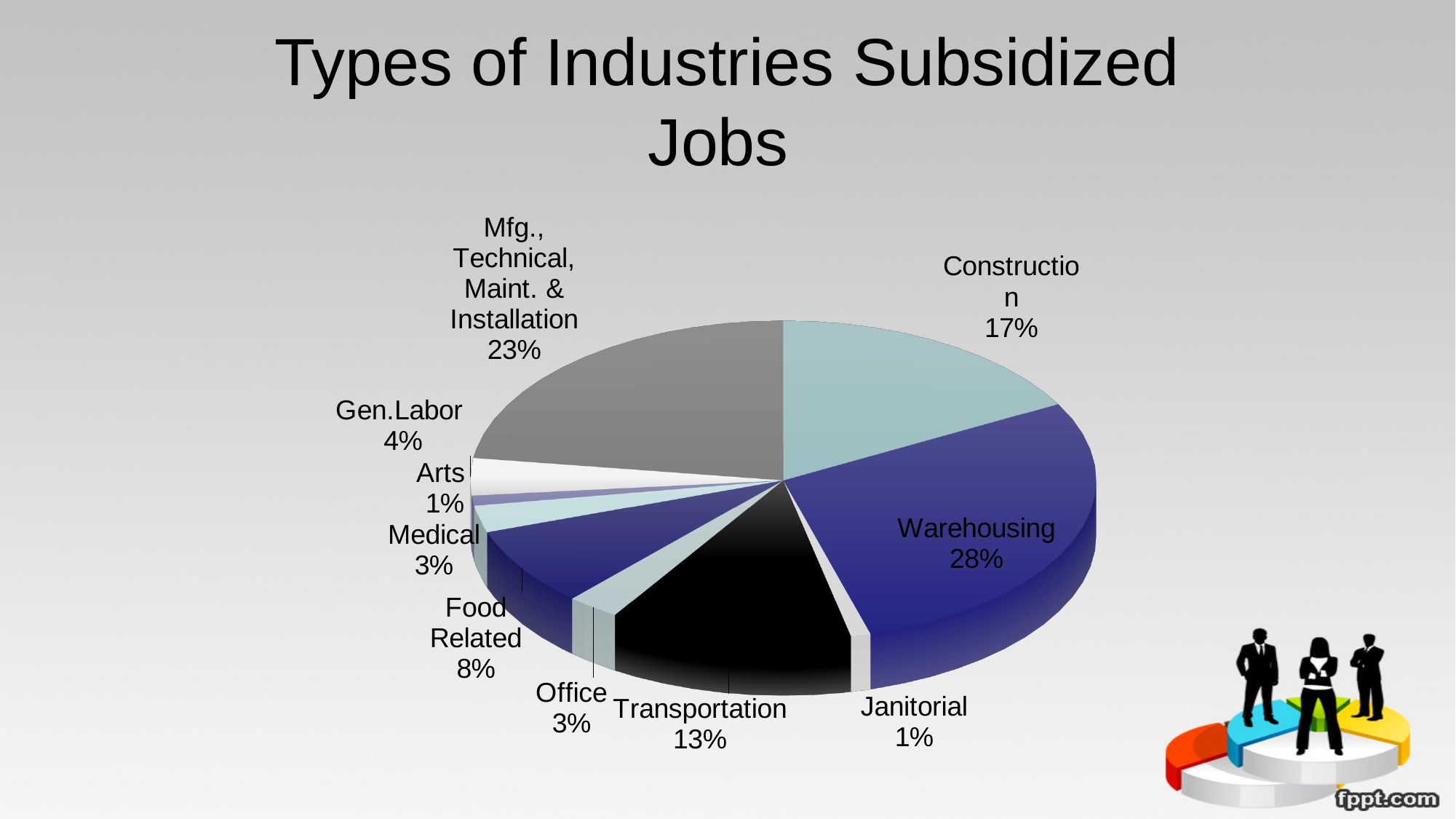
What percentage is shown for Construction? 17% What type of chart is shown on the slide? Pie chart Which has a larger share, Transportation or Food Related? Transportation What is the title of the chart? Types of Industries Subsidized Jobs What percentage is shown for Mfg., Technical, Maint. & Installation? 23% What share does Transportation have? 13% What is the difference in percentage points between Warehousing and Construction? 11 Which industry has the largest share of subsidized jobs? Warehousing What percentage is shown for Food Related? 8% How many industry categories are shown in the pie chart? 10 What is the difference in percentage points between Mfg., Technical, Maint. & Installation and Gen.Labor? 19 What share of subsidized jobs is in Warehousing? 28%